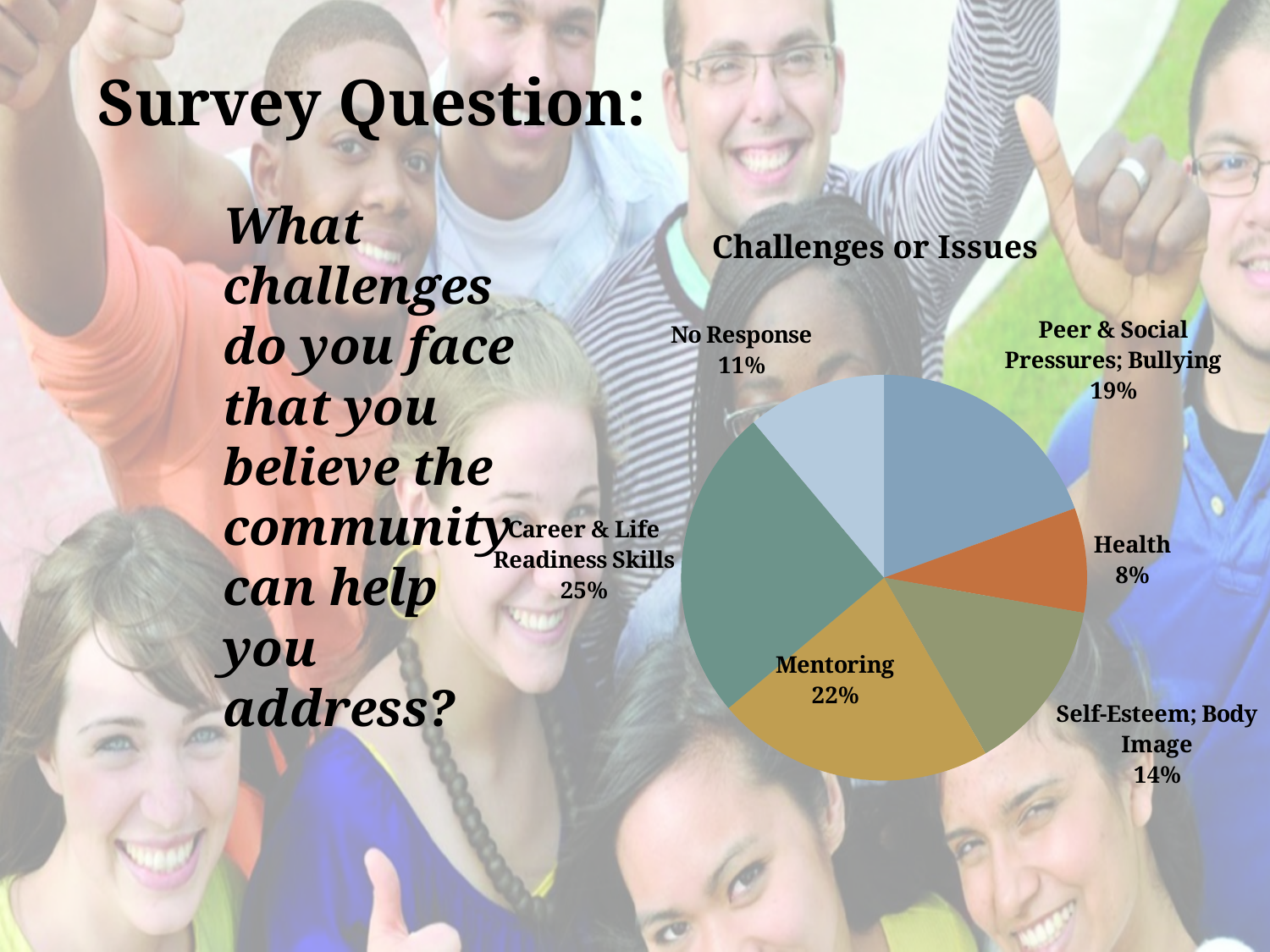
How many categories are shown in the pie chart? 6 What kind of chart is shown on the slide? pie chart What percentage is shown for Mentoring? 22% Which category has the largest slice of the pie? Career & Life Readiness Skills What percentage is shown for Health? 8% What is the title of the chart? Challenges or Issues What share of the pie is Career & Life Readiness Skills? 25% Which category has the smallest slice of the pie? Health Which is larger, Peer & Social Pressures; Bullying or No Response? Peer & Social Pressures; Bullying What is the difference between the Mentoring and Self-Esteem; Body Image percentages? 8% What percentage is shown for Peer & Social Pressures; Bullying? 19% What percentage is shown for No Response? 11%